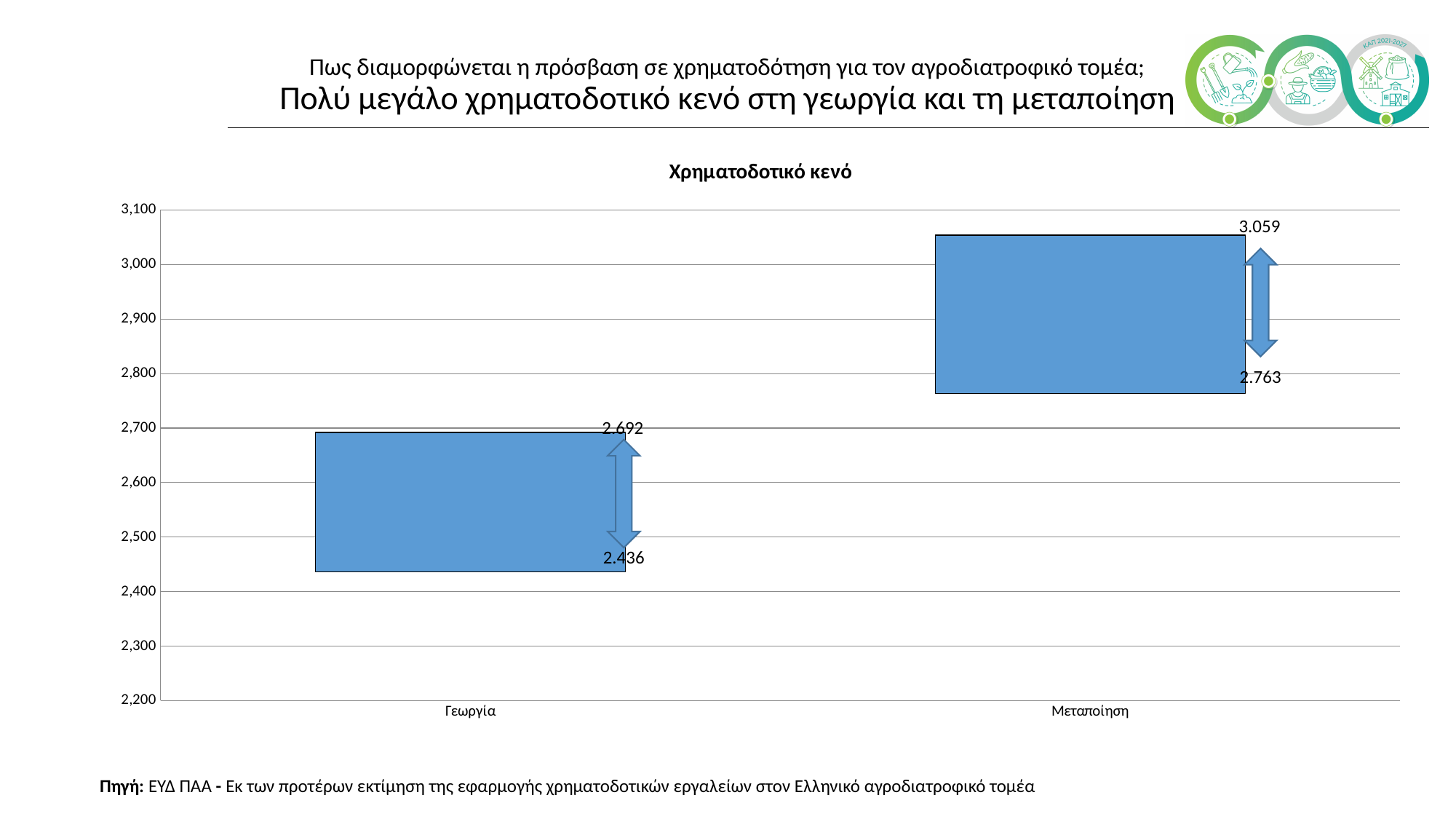
What is the upper value printed for Μεταποίηση? 3.059 What is the upper value printed for Γεωργία? 2.692 How many categories are shown on the x axis of the chart? 2 Is the lower value for Γεωργία greater or less than 2,500? less What type of chart is shown on the slide? bar chart Is the upper value for Μεταποίηση greater or less than 3,000? greater Which category has the higher upper value, Γεωργία or Μεταποίηση? Μεταποίηση What is the lower value printed for Γεωργία? 2.436 Which category has the lowest lower value? Γεωργία What is the title of the chart? Χρηματοδοτικό κενό What colour are the bars in the chart? blue What is the lower value printed for Μεταποίηση? 2.763